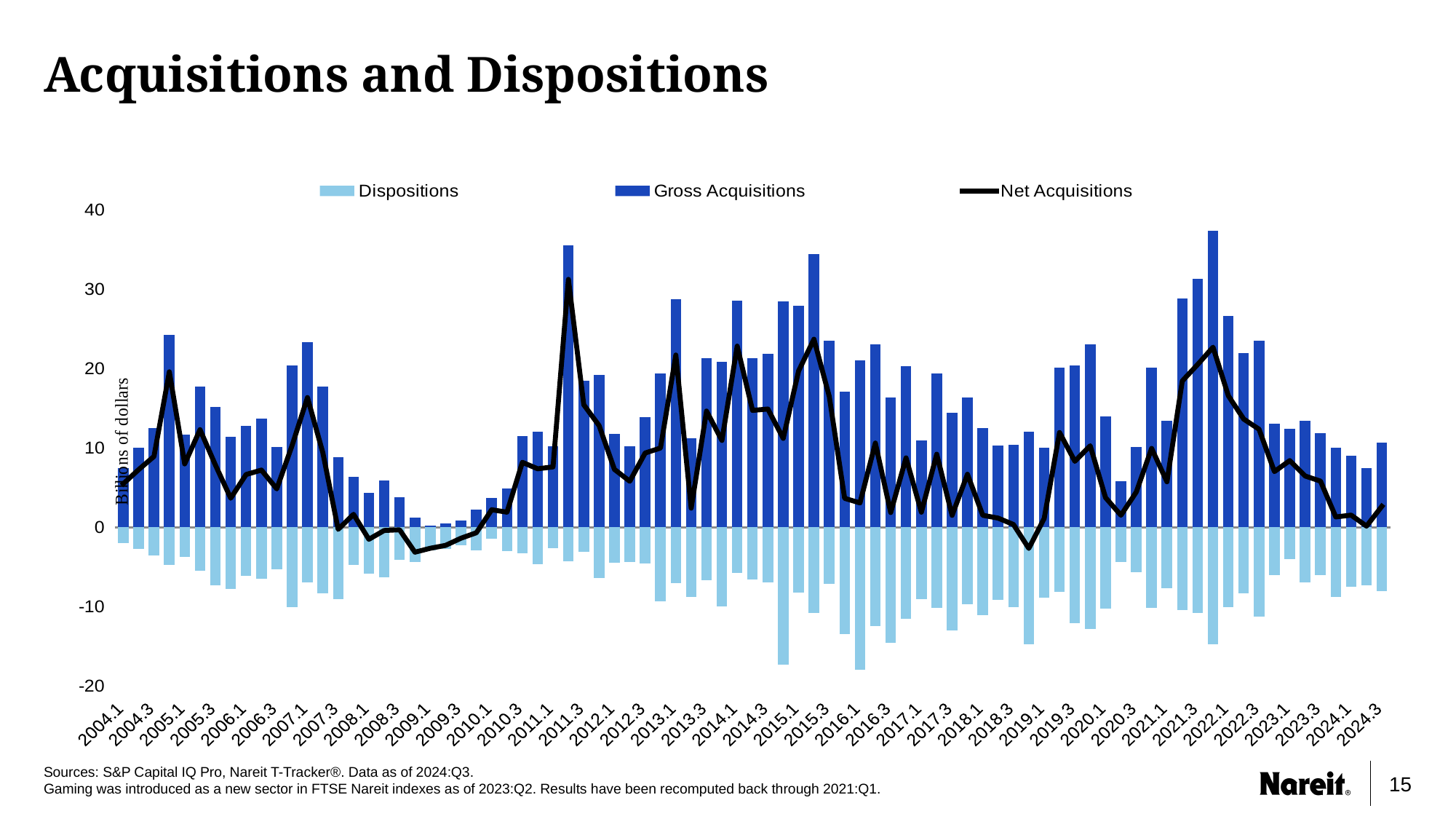
What kind of chart is used to show Net Acquisitions? Line chart What kind of chart is used to show Gross Acquisitions? Bar chart Is the Dispositions value for 2015.1 greater or less than -10? greater What is the title of the chart? Acquisitions and Dispositions Do Gross Acquisitions generally rise or fall from 2022.1 to 2024.1? fall Is the Gross Acquisitions value for 2011.3 greater or less than 30? less Is the Gross Acquisitions value for 2009.1 greater or less than 10? less What is the label on the vertical axis? Billions of dollars How many series does the legend list? 3